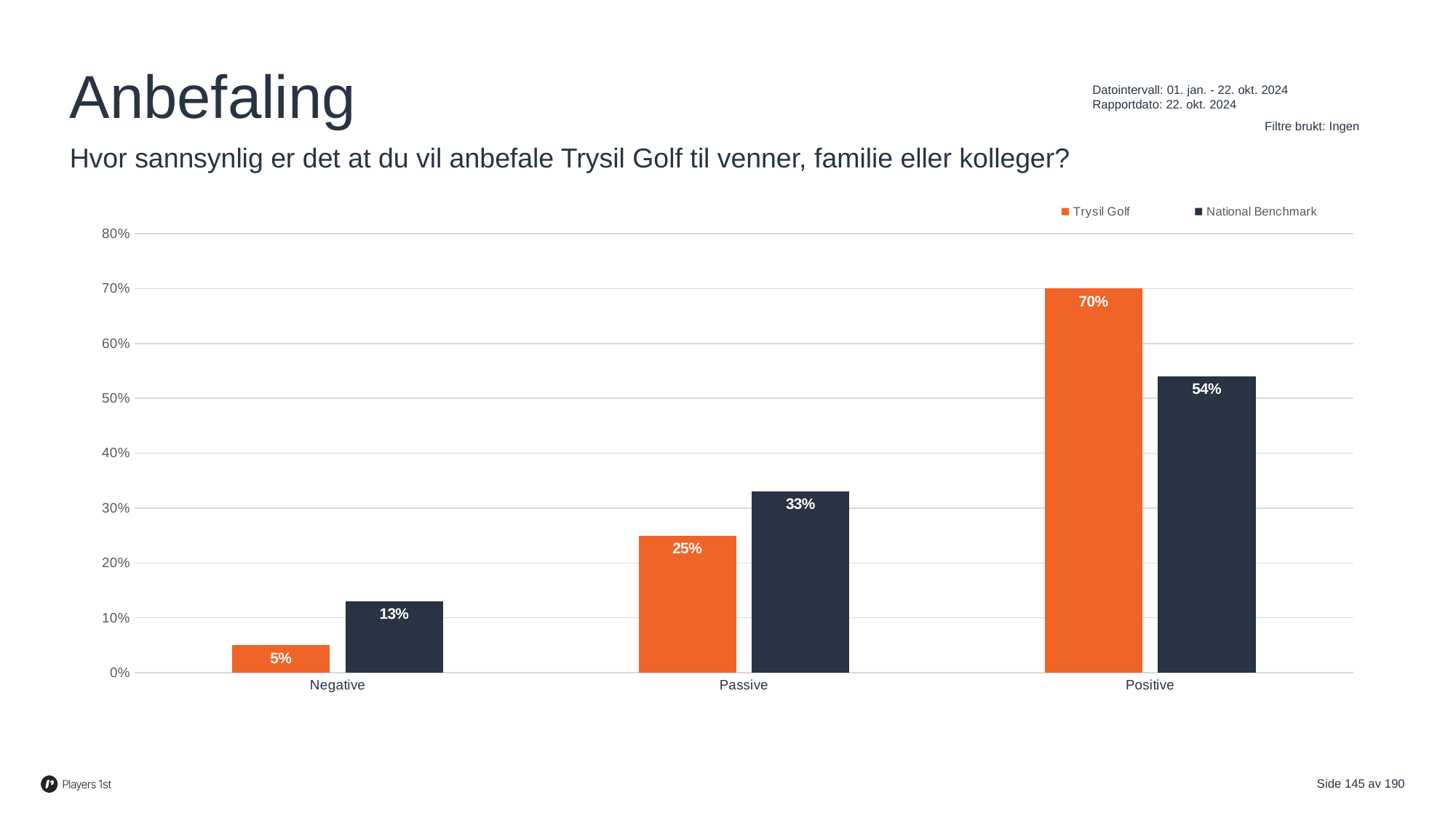
What is the difference between the Trysil Golf and National Benchmark values for Positive? 16% What kind of chart is shown on the slide? Bar chart What is the National Benchmark value for Passive? 33% What is the National Benchmark value for Negative? 13% What is the Trysil Golf value for Positive? 70% What is the Trysil Golf value for Negative? 5% Which category has the highest Trysil Golf value? Positive For Passive, which is larger: Trysil Golf or National Benchmark? National Benchmark Which series is shown in orange? Trysil Golf How many series does the legend list? 2 Which category has the lowest National Benchmark value? Negative How many categories are shown on the x axis? 3